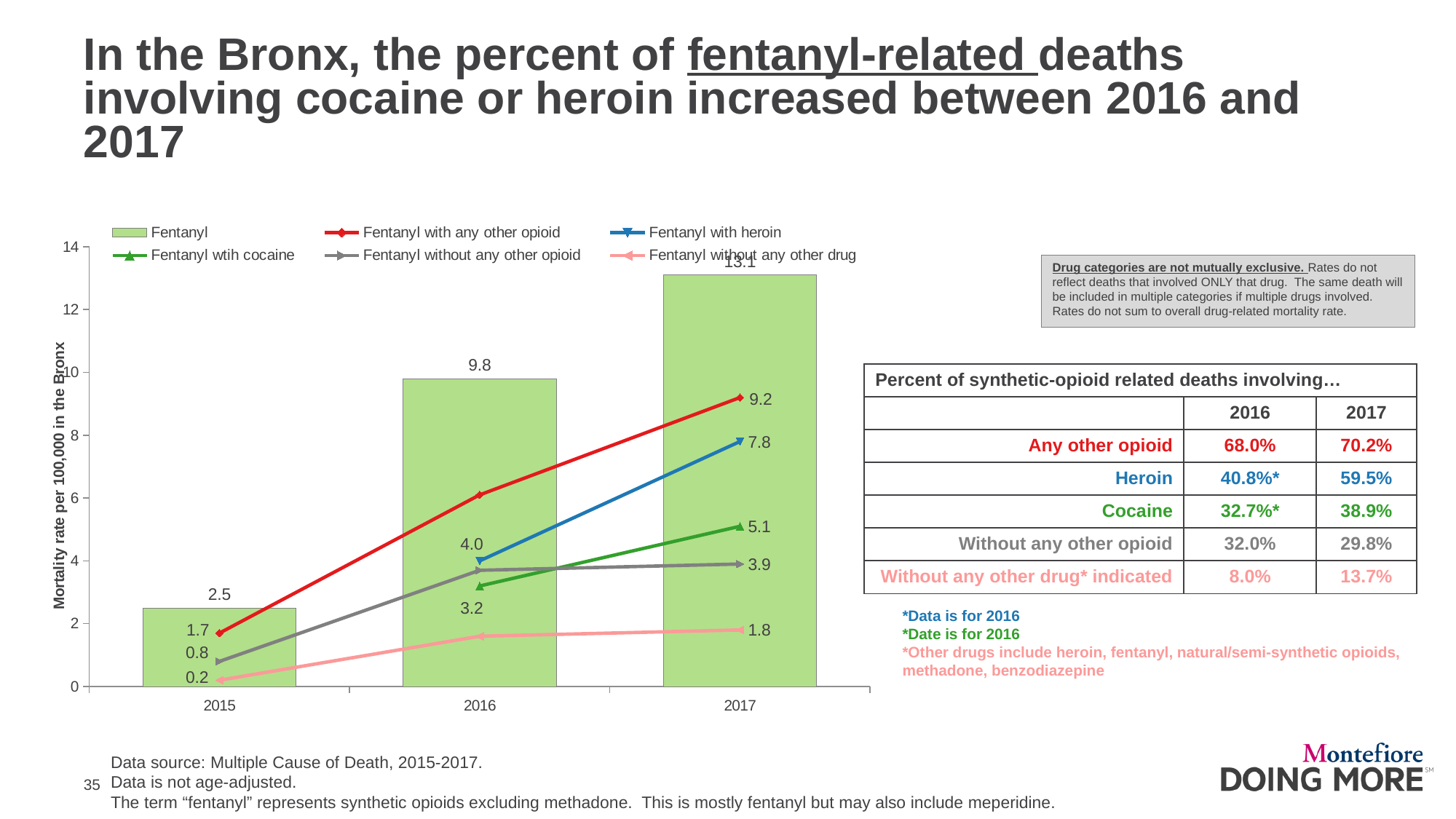
What is the Fentanyl mortality rate per 100,000 in the Bronx for 2017? 13.1 What is the value for Fentanyl with any other opioid in 2017? 9.2 How many years are shown on the x axis of the chart? 3 What is the Fentanyl mortality rate per 100,000 in the Bronx for 2016? 9.8 Do the Fentanyl bars rise or fall from 2015 to 2017? rise By how much did the Fentanyl mortality rate increase from 2016 to 2017? 3.3 In 2017, which is larger: Fentanyl with heroin or Fentanyl with cocaine? Fentanyl with heroin What kind of chart is shown on the slide? A combination bar and line chart How many series does the chart legend list? 6 What is the value for Fentanyl with heroin in 2017? 7.8 What is the value for Fentanyl with cocaine in 2016? 3.2 Is the value for Fentanyl without any other drug in 2016 greater or less than 2? less